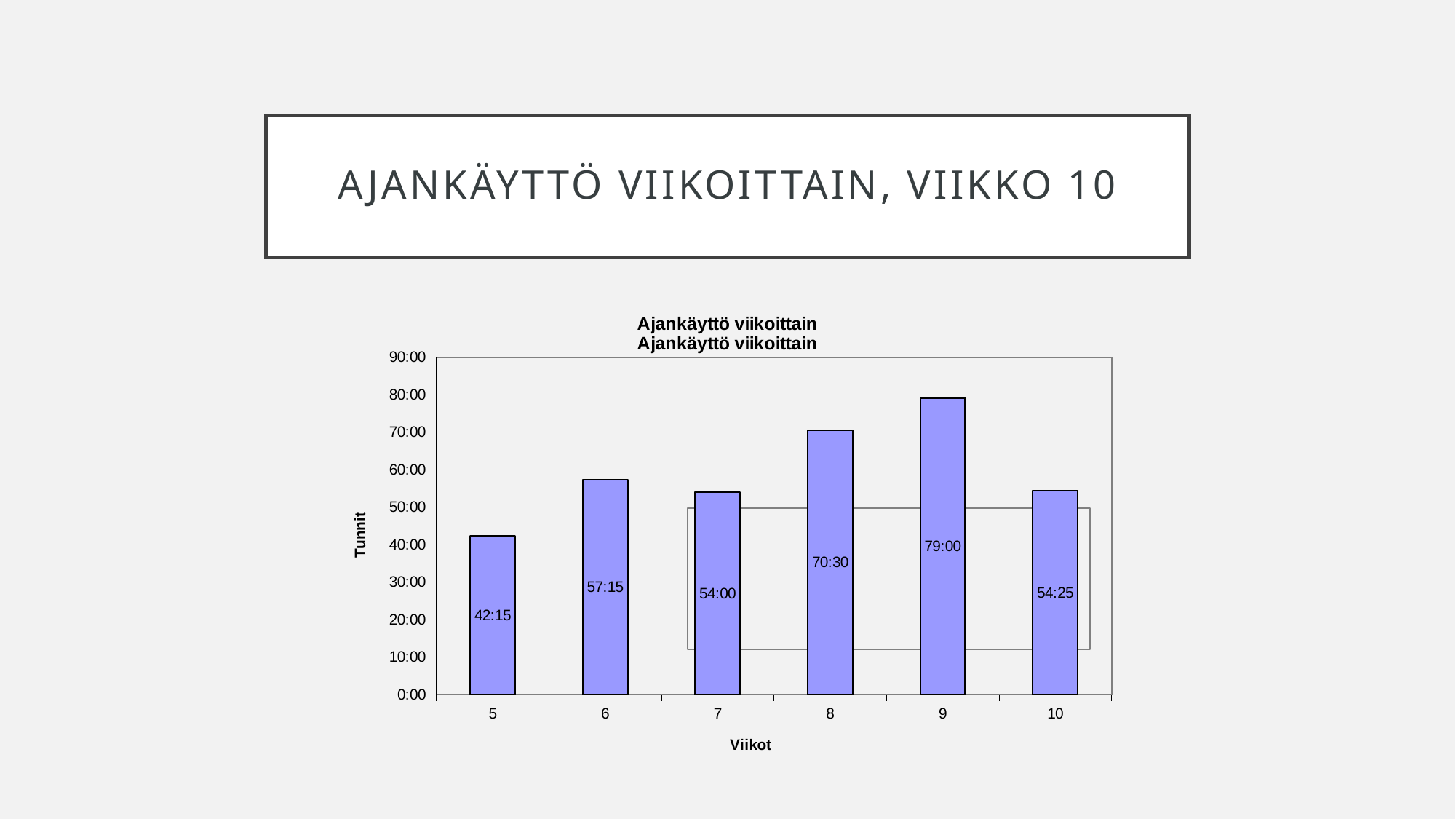
Is the value for week 9 greater or less than 70:00? greater What is the difference between the values for week 8 and week 7? 16:30 What kind of chart is shown on the slide? bar chart Which is larger, the value for week 6 or the value for week 8? week 8 What is the difference between the values for week 9 and week 5? 36:45 What is the value for week 5? 42:15 What is the value for week 8? 70:30 What is the value for week 10? 54:25 Which week has the lowest value? 5 How many weeks are shown on the x axis? 6 Which week has the highest value? 9 What is the label of the y axis? Tunnit